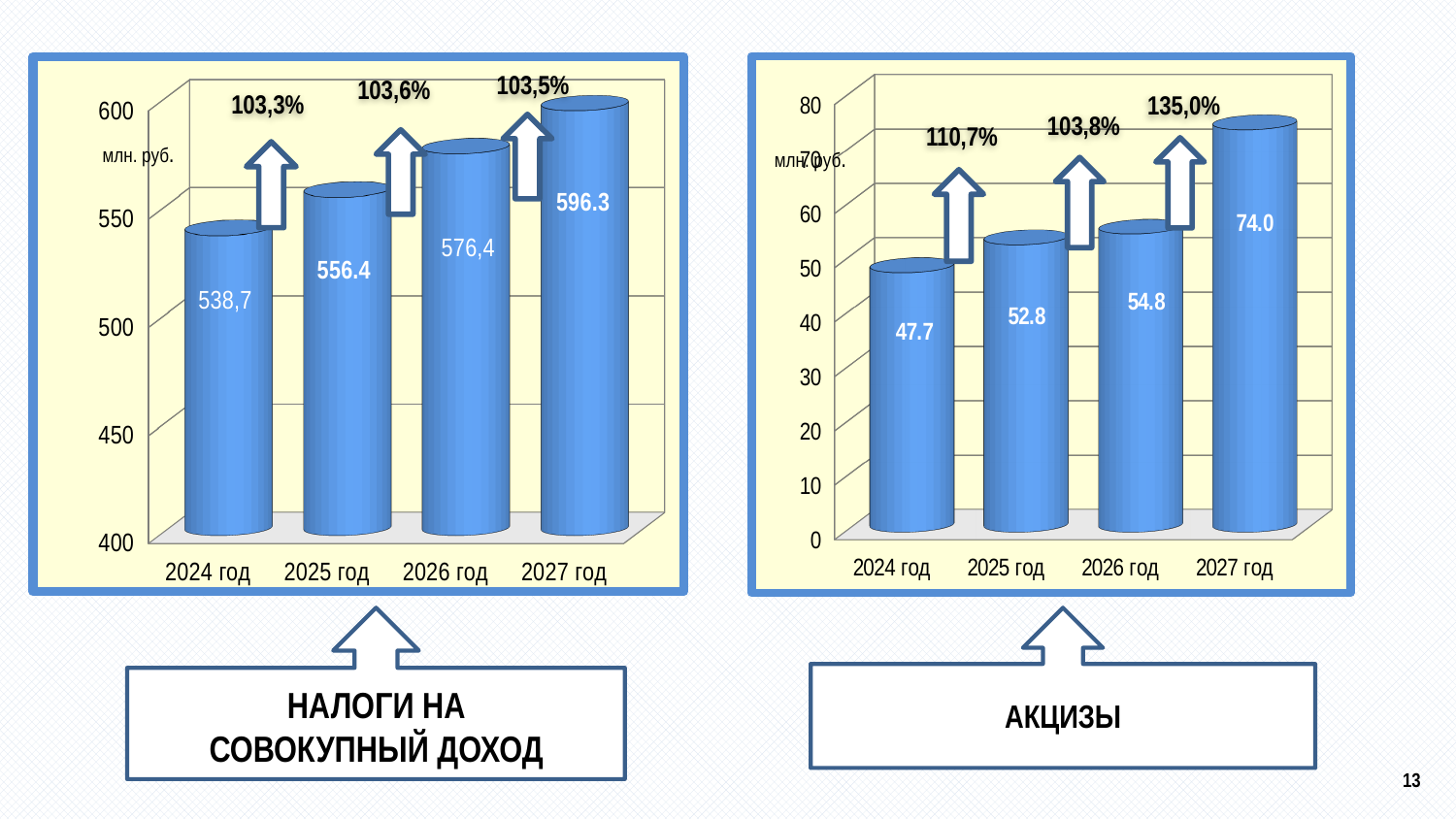
In the chart labelled АКЦИЗЫ (right), what is the difference between the values for 2026 год and 2025 год? 2.0 In the chart labelled НАЛОГИ НА СОВОКУПНЫЙ ДОХОД (left), which is larger: the value for 2026 год or the value for 2025 год? 2026 год In the chart labelled АКЦИЗЫ (right), what is the value for 2027 год? 74.0 In the chart labelled АКЦИЗЫ (right), do the values rise or fall from 2024 год to 2027 год? Rise In the chart labelled НАЛОГИ НА СОВОКУПНЫЙ ДОХОД (left), which year has the highest value? 2027 год How many years are shown on the x axis of the chart labelled АКЦИЗЫ (right)? 4 In the chart labelled НАЛОГИ НА СОВОКУПНЫЙ ДОХОД (left), what is the value for 2024 год? 538,7 In the chart labelled НАЛОГИ НА СОВОКУПНЫЙ ДОХОД (left), what is the value for 2025 год? 556.4 In the chart labelled АКЦИЗЫ (right), what is the difference between the values for 2027 год and 2024 год? 26.3 In the chart labelled АКЦИЗЫ (right), what is the value for 2026 год? 54.8 In the chart labelled АКЦИЗЫ (right), which year has the lowest value? 2024 год What kind of chart is the chart labelled НАЛОГИ НА СОВОКУПНЫЙ ДОХОД (left)? Bar chart